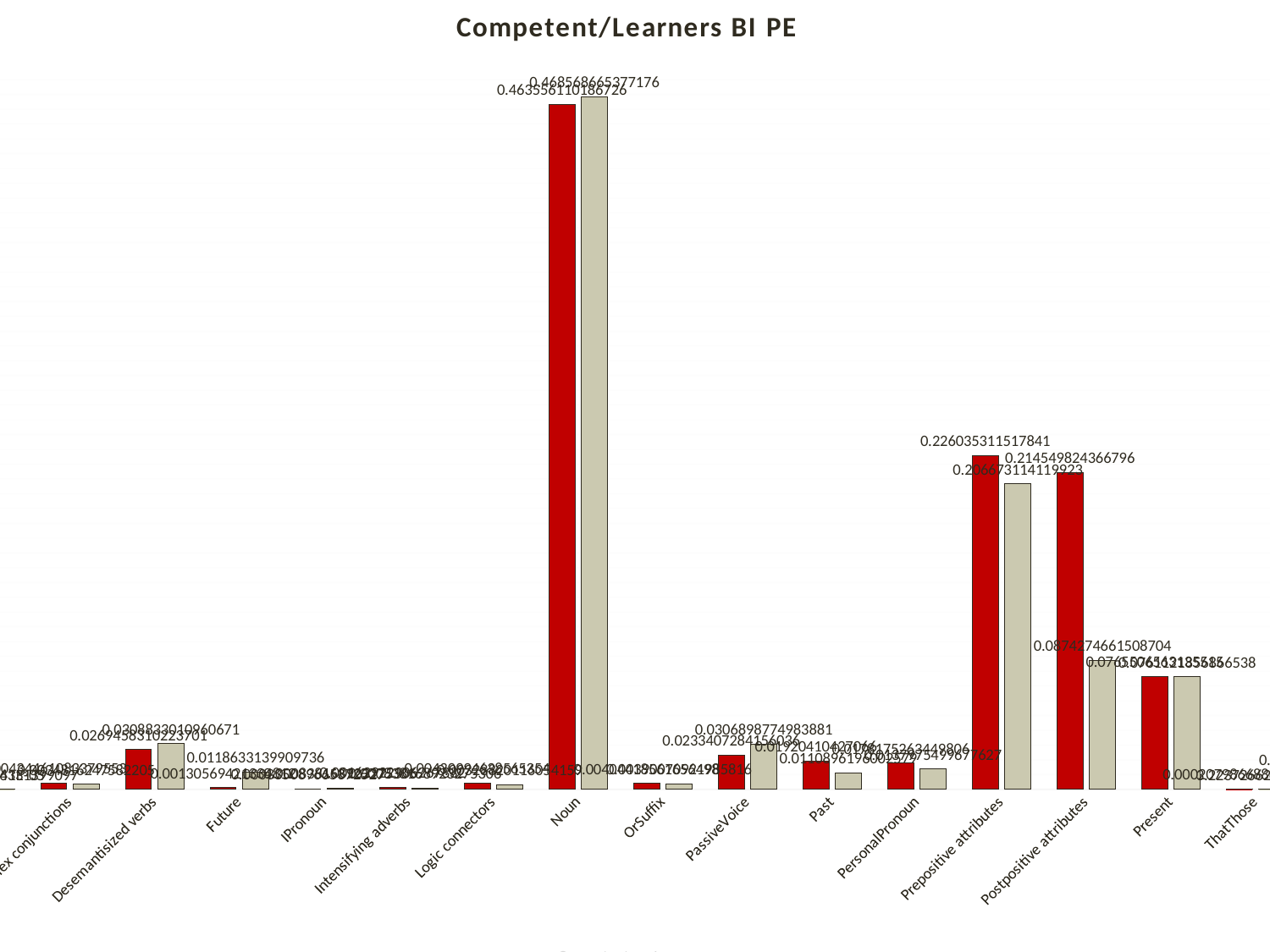
What is the title of the chart? Competent/Learners BI PE Which category has taller bars, Present or Past? Present What is the value of the red bar for Postpositive attributes? 0.214549824366796 Which category has taller bars, Noun or Present? Noun What is the value of the red bar for Prepositive attributes? 0.226035311517841 Which category has the tallest bars in the chart? Noun How many bars are plotted for each category? 2 For Prepositive attributes, which bar is taller, the red one or the beige one? the red one What is the value of the beige bar for Future? 0.0118633139909736 What type of chart is shown on the slide? bar chart